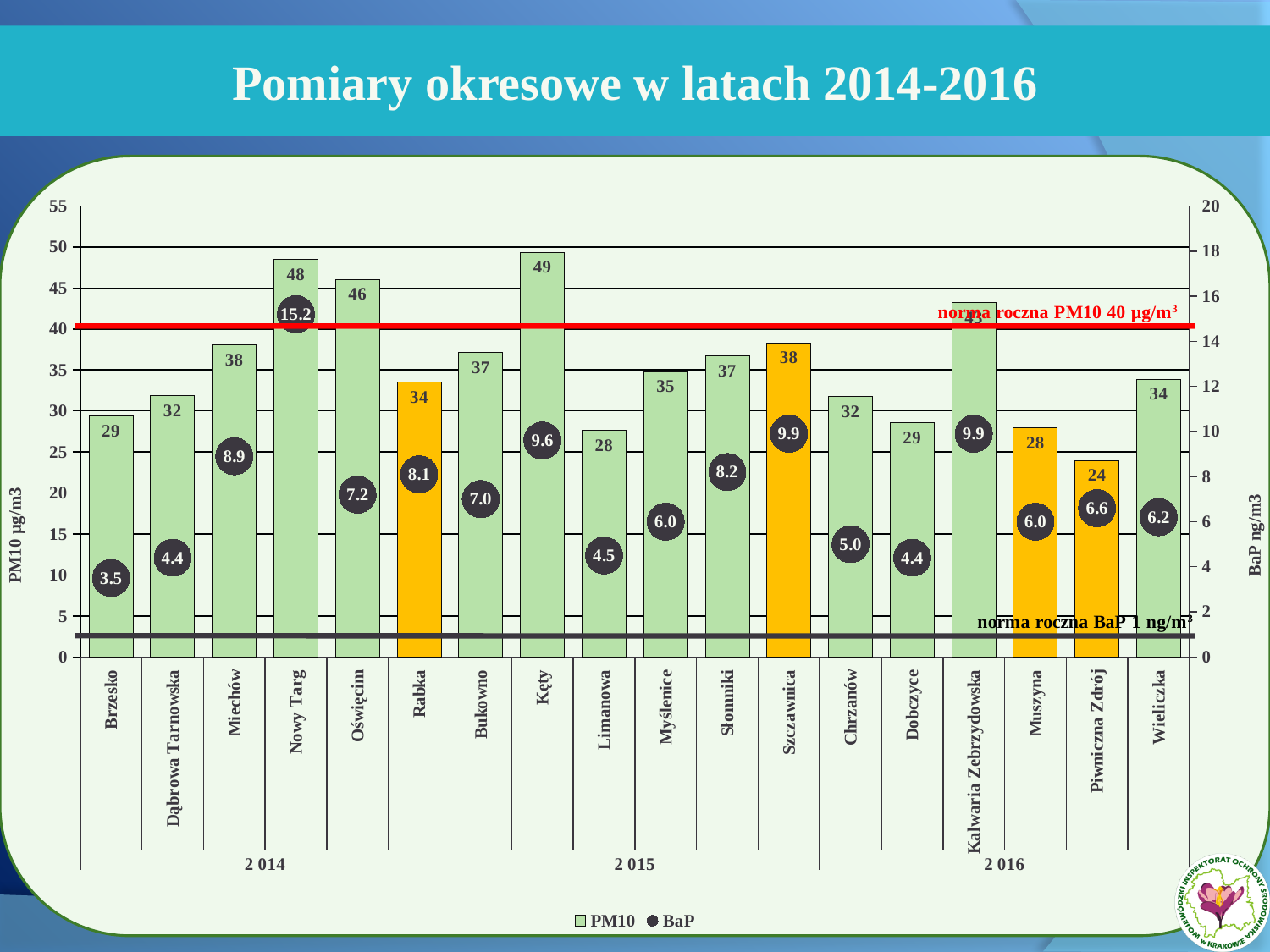
Is the PM10 value for Kęty greater or less than 40? greater What kind of chart is shown on the slide? combination bar and line chart (bars for PM10, markers for BaP) What is the difference between the PM10 values for Oświęcim and Rabka? 12 What is the BaP value for Kęty? 9.6 How many locations are shown on the x axis? 18 Which location has the highest PM10 value? Kęty Which location has the highest BaP value? Nowy Targ How many series does the legend list? 2 Which location has the lowest PM10 value? Piwniczna Zdrój Which location has the lowest BaP value? Brzesko What is the PM10 value for Nowy Targ? 48 Which has a higher BaP value, Miechów or Rabka? Miechów